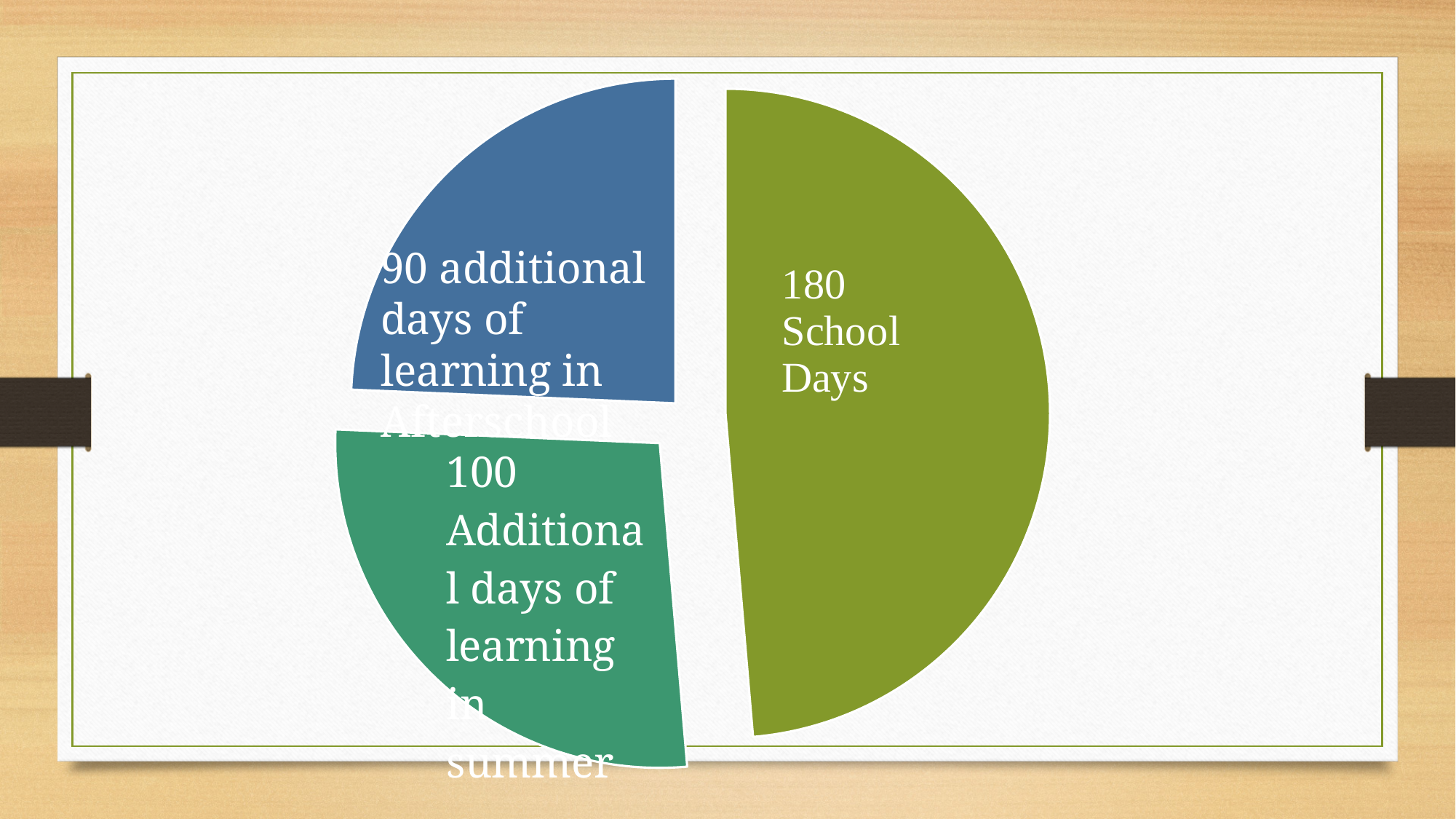
How many additional days of learning in summer are shown on the pie chart? 100 What is the difference between the 180 School Days and the 100 additional days of learning in summer? 80 How many slices does the pie chart have? 3 What colour is the 180 School Days slice of the pie chart? Olive green Which slice of the pie chart is the smallest? 90 additional days of learning in Afterschool Which is larger: the additional days of learning in summer or the additional days of learning in Afterschool? Additional days of learning in summer What is the difference between the additional days of learning in summer and the additional days of learning in Afterschool? 10 How many additional days of learning in Afterschool are shown on the pie chart? 90 Which slice of the pie chart is the largest? 180 School Days How many school days does the largest slice of the pie chart represent? 180 What is the total number of days represented by all three slices of the pie chart? 370 What kind of chart is shown on the slide? Pie chart